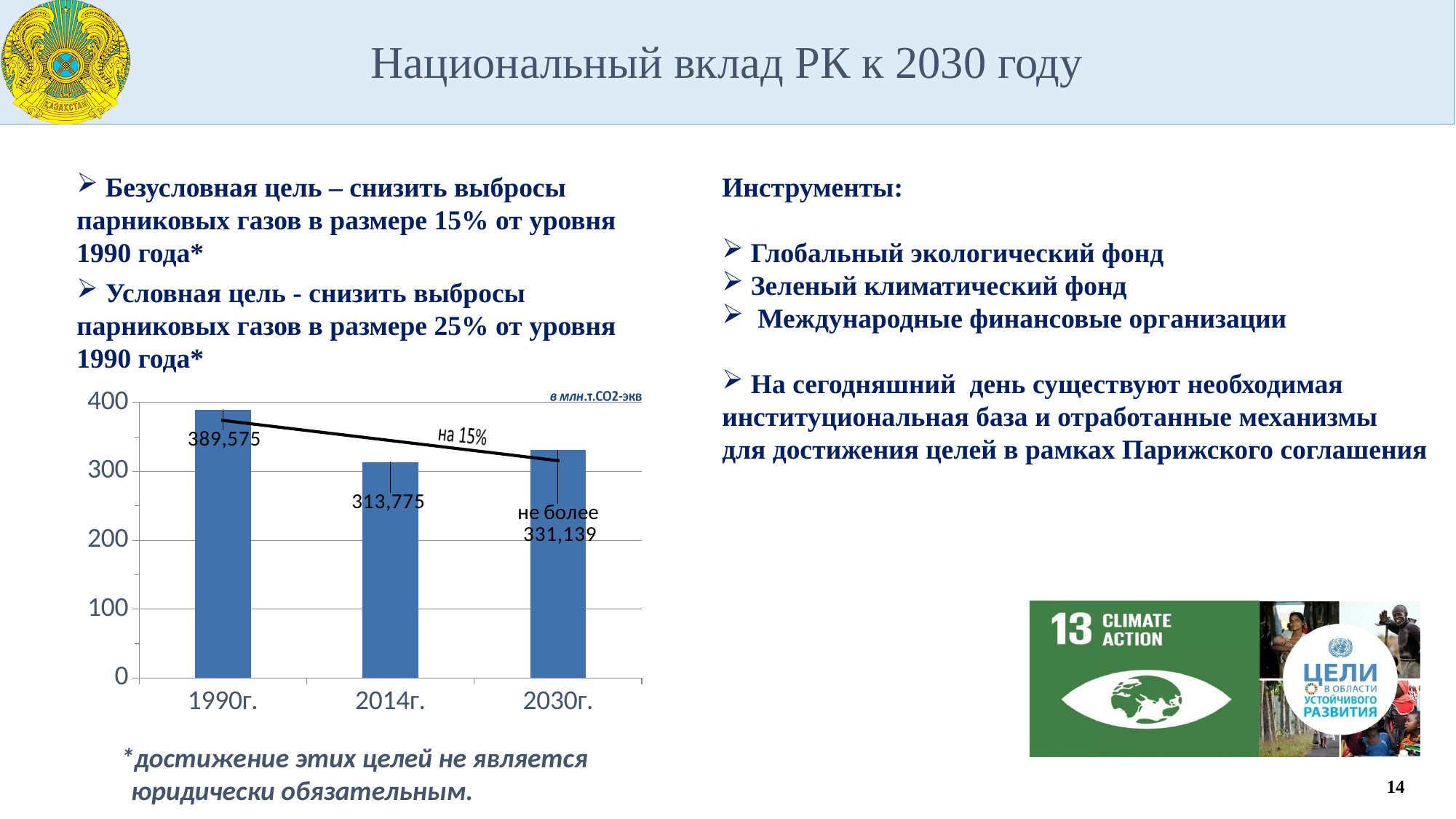
Which year has the lowest bar in the chart? 2014г. What is the value shown for 1990г. in the chart? 389,575 Which year has the highest bar in the chart? 1990г. Is the value for 2014г. greater or less than 300? greater What is the value shown for 2014г. in the chart? 313,775 What percentage reduction is written on the line drawn from the 1990г. bar to the 2030г. bar? на 15% How many categories (years) are shown on the x axis of the chart? 3 Which is larger in the chart, the value for 1990г. or the value for 2030г.? 1990г. What unit is indicated in the top right corner of the chart? в млн.т.СО2-экв Is the value for 1990г. greater or less than 400? less What type of chart is shown on the slide? bar chart What value is labelled for 2030г. in the chart? не более 331,139